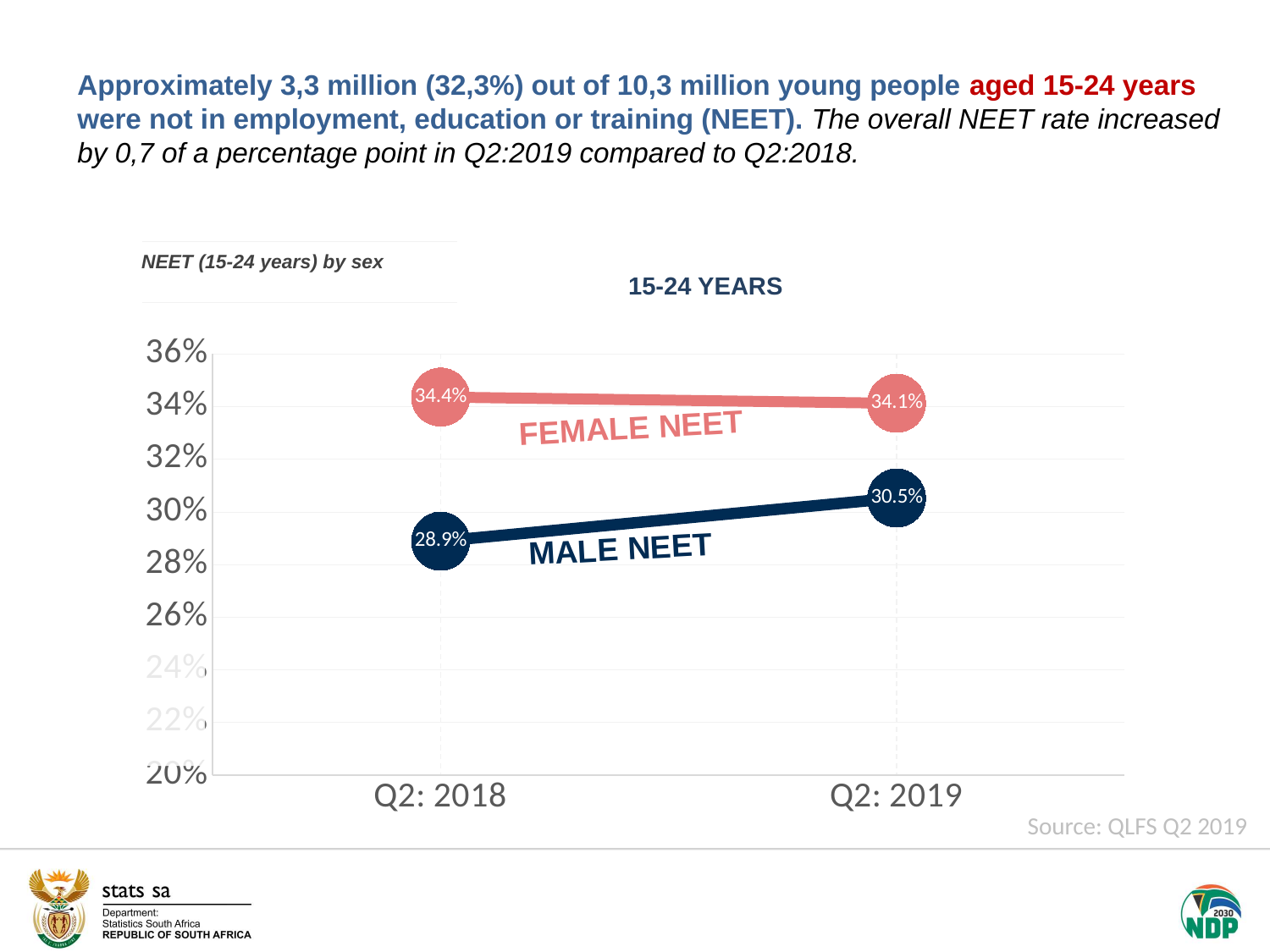
Does the female NEET rate rise or fall from Q2: 2018 to Q2: 2019? Fall Which series has the higher value in Q2: 2019, female NEET or male NEET? Female NEET How many time periods are shown on the x axis? 2 What is the male NEET rate in Q2: 2019? 30.5% By how many percentage points did the male NEET rate change from Q2: 2018 to Q2: 2019? 1.6 What is the difference between the female and male NEET rates in Q2: 2018? 5.5 What kind of chart is shown on the slide? Line chart What is the title of the chart? NEET (15-24 years) by sex What is the female NEET rate in Q2: 2018? 34.4% What is the female NEET rate in Q2: 2019? 34.1% Does the male NEET rate rise or fall from Q2: 2018 to Q2: 2019? Rise What is the male NEET rate in Q2: 2018? 28.9%